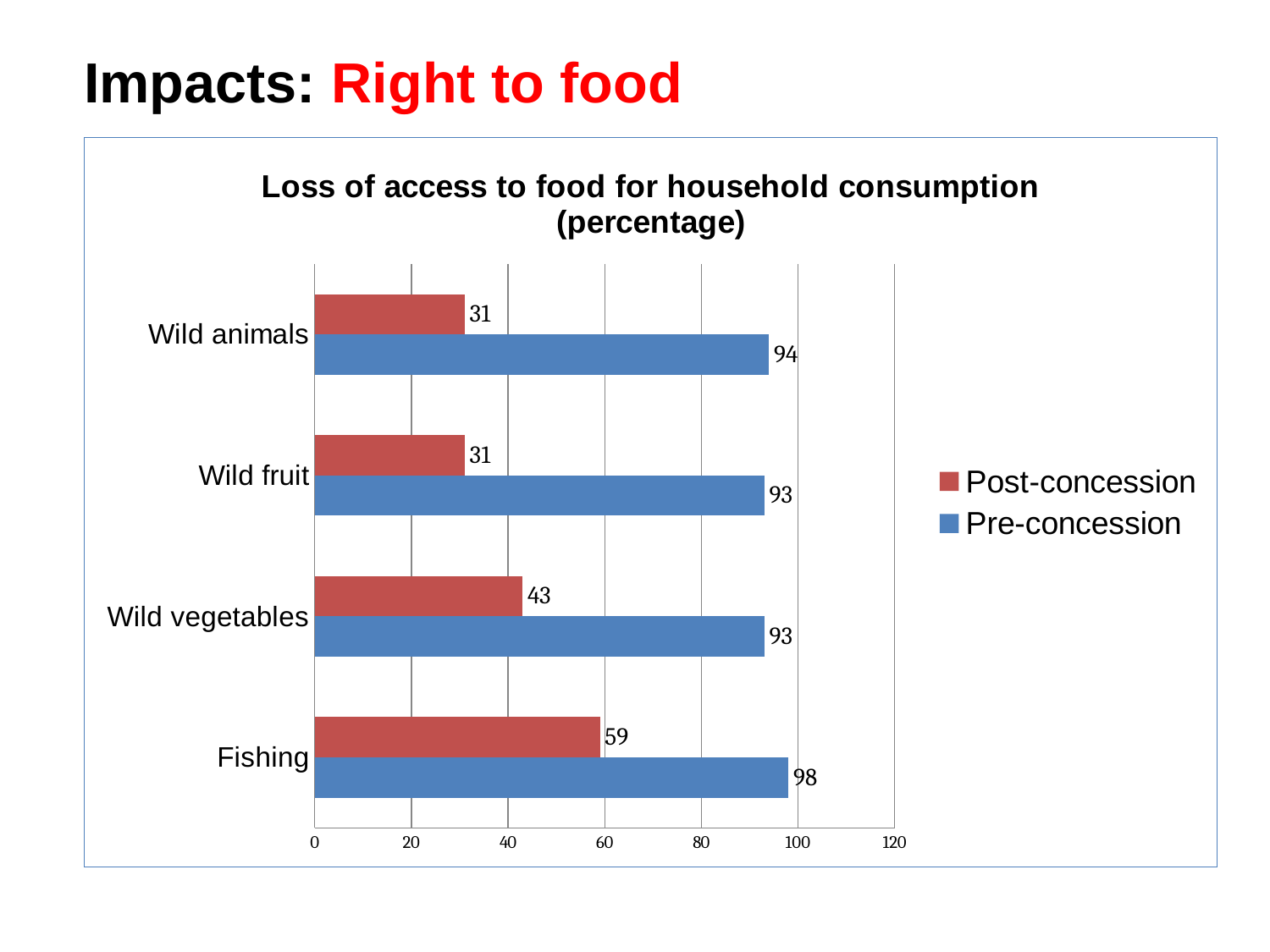
What is the difference between the Pre-concession and Post-concession values for Wild animals? 63 What is the Post-concession value for Wild vegetables? 43 Which category has the lowest Pre-concession value? Wild fruit and Wild vegetables (both 93) What is the difference between the Pre-concession and Post-concession values for Fishing? 39 What kind of chart is shown on the slide? Bar chart Which category has the highest Pre-concession value? Fishing What is the Pre-concession value for Fishing? 98 Which category has the highest Post-concession value? Fishing What is the Post-concession value for Wild animals? 31 Which is larger: the Post-concession value for Wild vegetables or the Post-concession value for Wild fruit? Wild vegetables How many categories are shown on the chart? 4 How many series does the legend list? 2